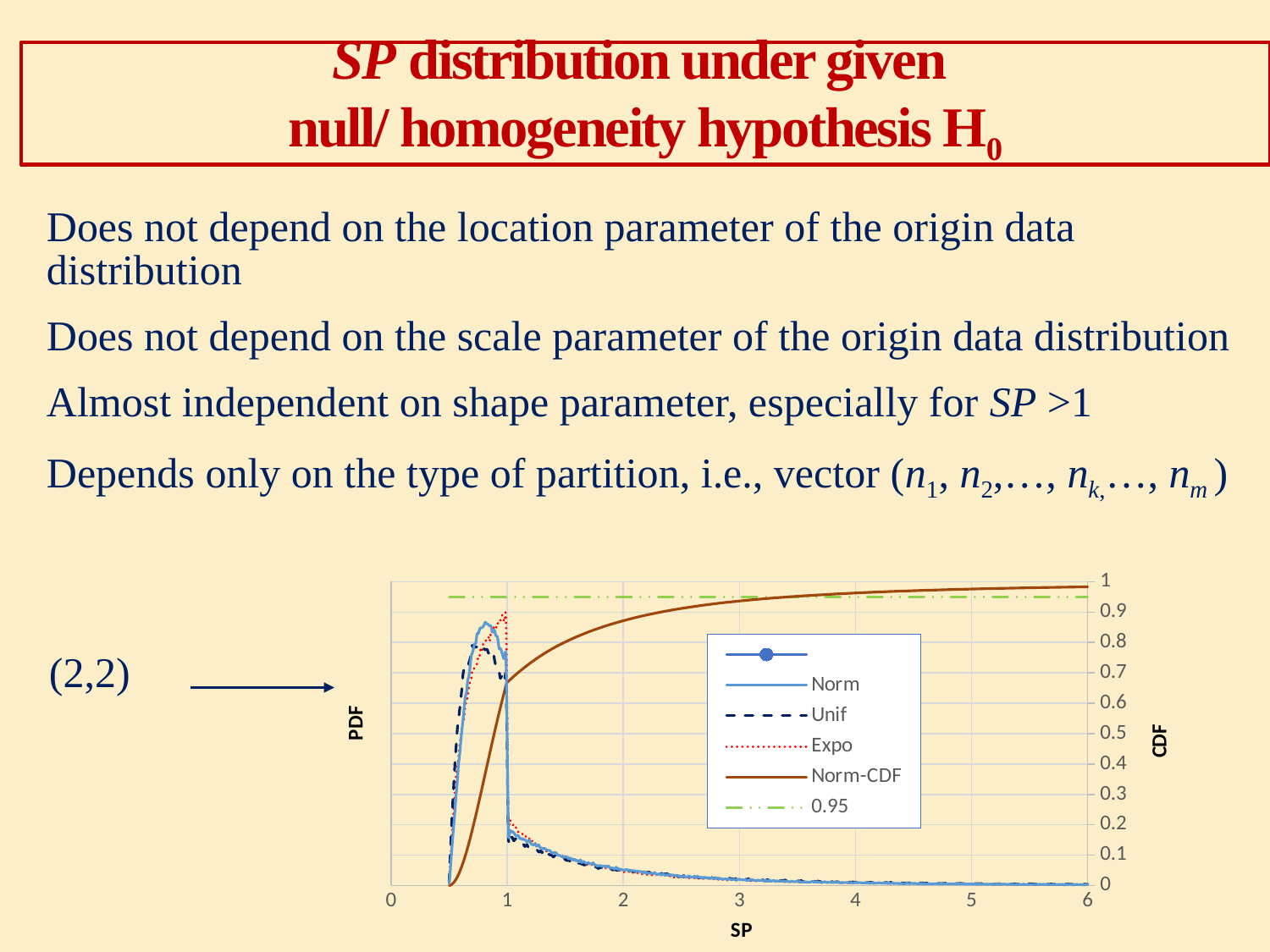
At SP = 5, which is higher on the CDF axis: the Norm-CDF series or the 0.95 line? Norm-CDF Does the Norm-CDF series rise or fall as SP increases from 1 to 6? rise Is the value of the Norm-CDF series at SP = 6 greater or less than 0.9 on the CDF axis? greater How many labelled entries does the chart legend list? 5 What is the highest tick value shown on the right-hand CDF axis? 1 What is the highest tick value shown on the horizontal SP axis? 6 Do the Norm, Unif and Expo PDF curves rise or fall as SP increases from 1 to 6? fall Which legend entry is drawn as a red dotted line? Expo Is the value of the Norm-CDF series at SP = 2 greater or less than 0.95 on the CDF axis? less What is the title of the horizontal axis of the chart? SP What kind of chart is shown on the slide? line chart Is the value of the Norm-CDF series at SP = 1 greater or less than 0.5 on the CDF axis? greater